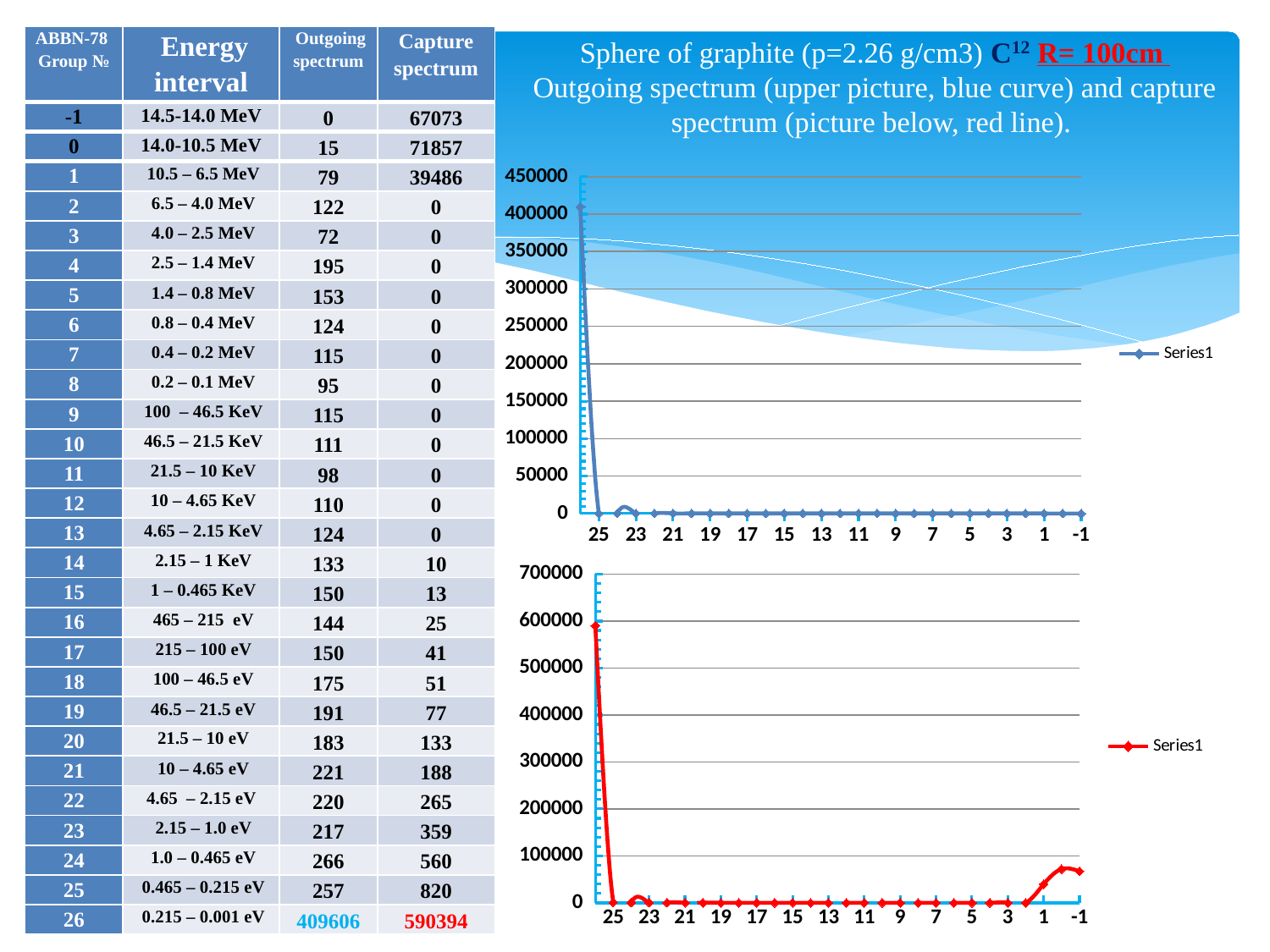
What colour is the line in the lower chart? red In the lower chart, which is larger: the value at x = 25 or the value at x = -1? x = -1 In the upper chart, is the value at x = 25 greater or less than 350000? less How many series does the legend of the lower chart list? 1 In the lower chart, is the value at x = -1 greater or less than 100000? less In the lower chart, is the value at x = 25 greater or less than 500000? less What kind of chart is the upper chart on the slide? line chart In the upper chart, do the values rise or fall moving from left to right along the x axis? fall How many series does the legend of the upper chart list? 1 What kind of chart is the lower chart on the slide? line chart